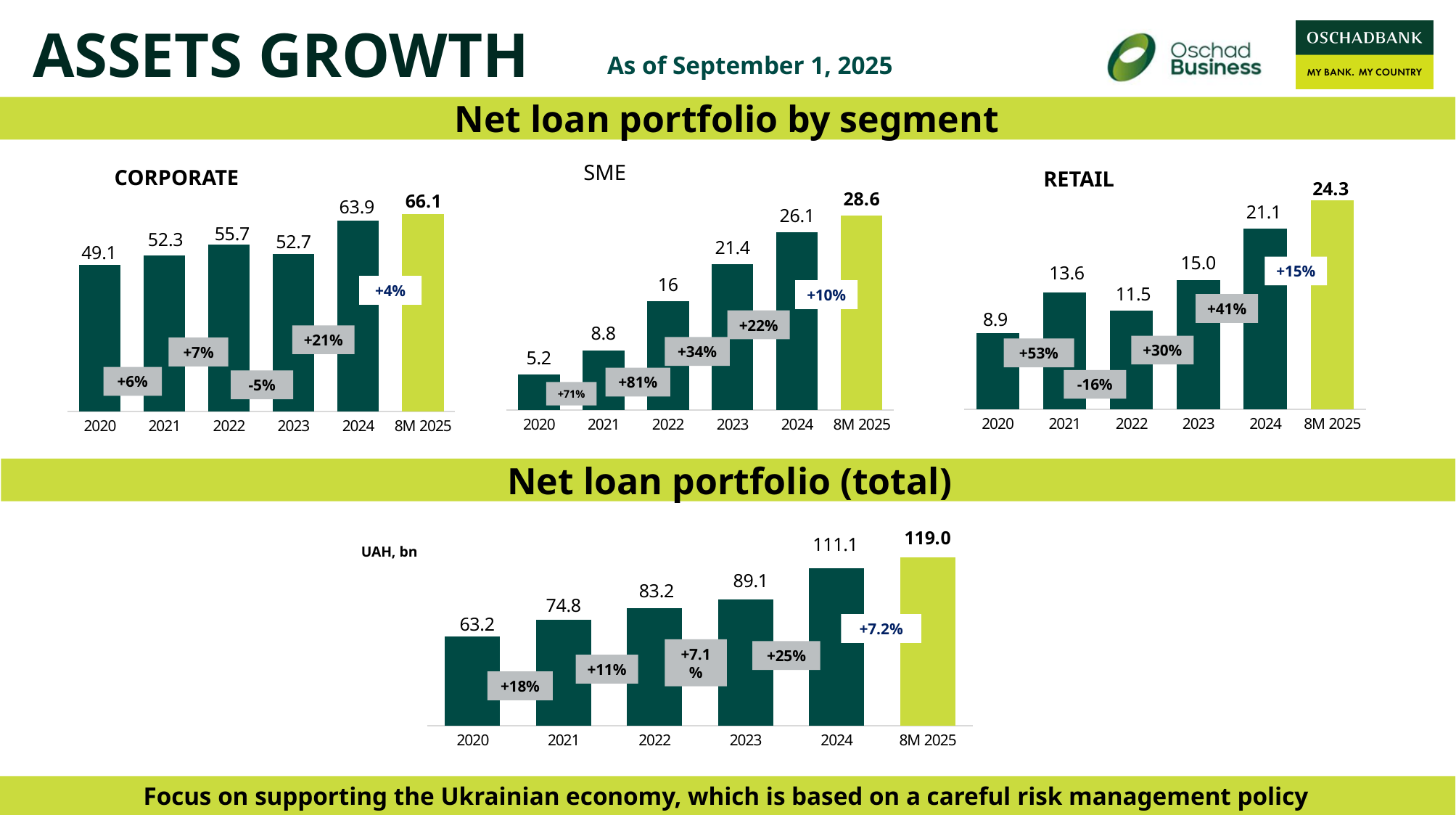
What kind of chart is the Net loan portfolio (total) chart? Bar chart In the SME chart, what is the value for 8M 2025? 28.6 In the RETAIL chart, which period has the highest value? 8M 2025 In the RETAIL chart, what is the value for 2022? 11.5 In the SME chart, do the values rise or fall from 2020 to 8M 2025? Rise In the Net loan portfolio (total) chart, what is the value for 2023? 89.1 In the SME chart, which is larger, the value for 2021 or the value for 2022? 2022 In the CORPORATE chart, what is the value for 2024? 63.9 How many bars are shown in the RETAIL chart? 6 In the Net loan portfolio (total) chart, what is the difference between the 2024 and 2023 values? 22.0 In the CORPORATE chart, which year has the lowest value? 2020 In the CORPORATE chart, what growth percentage is shown between 2022 and 2023? -5%